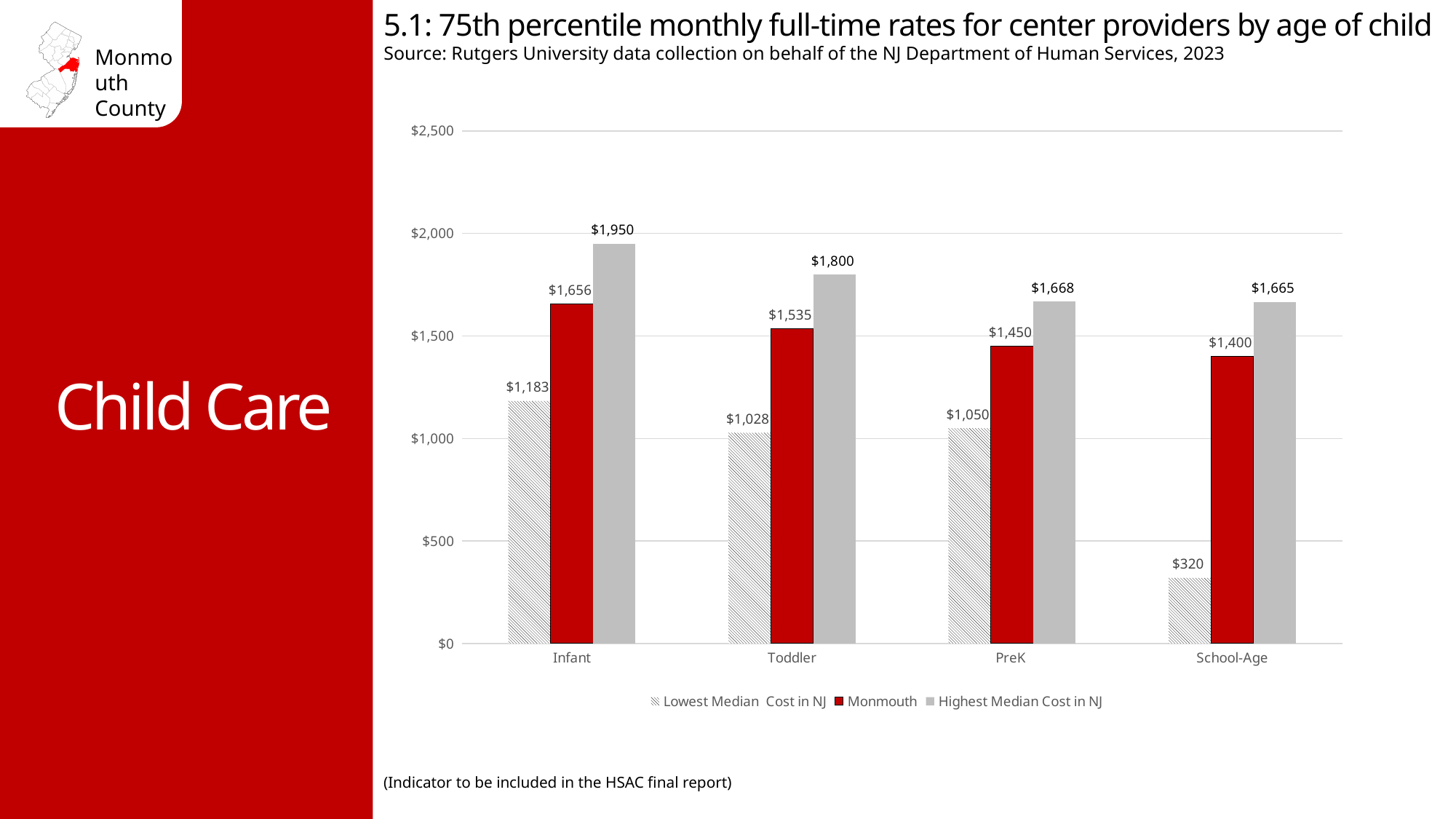
What is the difference between the Highest Median Cost in NJ and the Monmouth value for PreK? $218 What is the Highest Median Cost in NJ for Toddler? $1,800 Is the Monmouth value for School-Age greater or less than $1,500? less What kind of chart is shown on the slide? bar chart Which is larger: the Monmouth value for Toddler or the Monmouth value for School-Age? Toddler What is the Monmouth value for Infant? $1,656 Which age category has the lowest Lowest Median Cost in NJ value? School-Age What is the Lowest Median Cost in NJ for School-Age? $320 Which age category has the highest Monmouth value? Infant Which series is shown in red? Monmouth How many series does the legend list? 3 How many age categories are shown on the x axis? 4